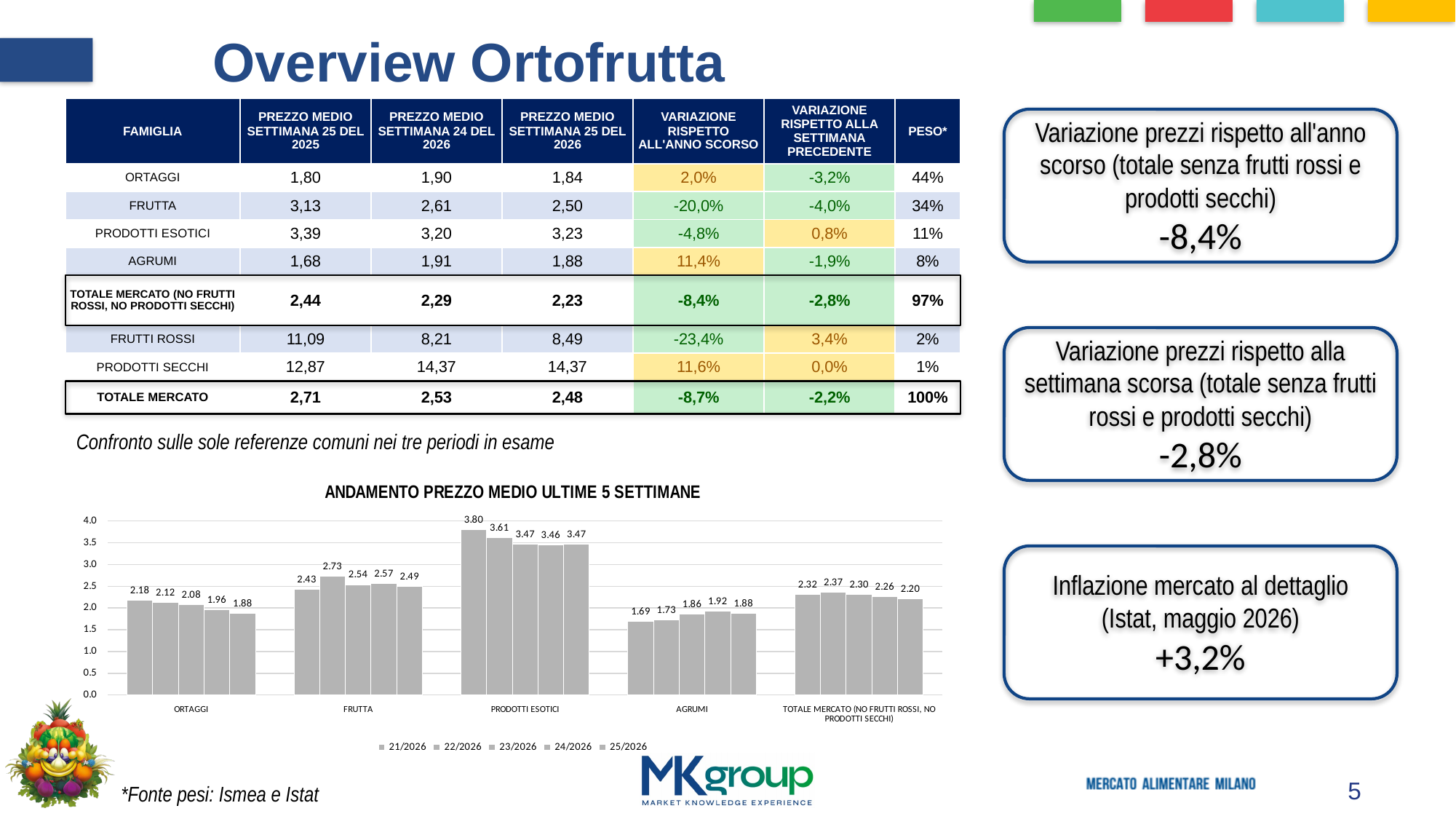
Do the ORTAGGI values rise or fall from 21/2026 to 25/2026? Fall Which category has the highest value in week 21/2026? PRODOTTI ESOTICI How many categories are shown on the x axis of the chart? 5 What is the value for PRODOTTI ESOTICI in week 21/2026? 3.80 What is the value for TOTALE MERCATO (NO FRUTTI ROSSI, NO PRODOTTI SECCHI) in week 22/2026? 2.37 Which category has the lowest value in week 21/2026? AGRUMI What is the difference between the ORTAGGI values for 21/2026 and 25/2026? 0.30 What is the value for ORTAGGI in week 25/2026? 1.88 How many series does the legend of the chart list? 5 Which is larger for AGRUMI: the value for 24/2026 or for 25/2026? 24/2026 What is the value for FRUTTA in week 22/2026? 2.73 What type of chart is 'ANDAMENTO PREZZO MEDIO ULTIME 5 SETTIMANE'? Bar chart